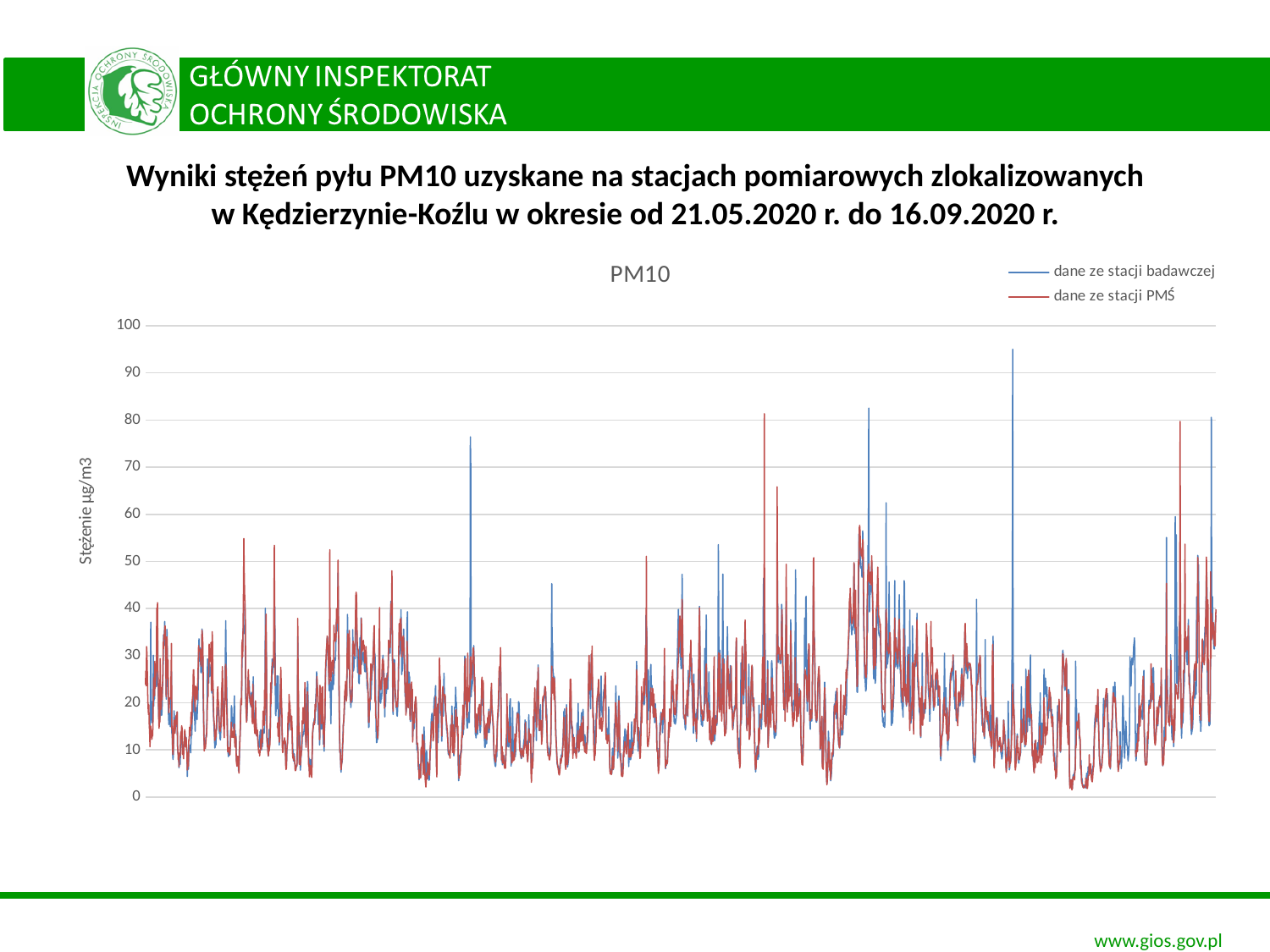
Is the highest peak of the 'dane ze stacji badawczej' series greater or less than 90? greater Which series reaches the higher maximum value in the chart, 'dane ze stacji badawczej' or 'dane ze stacji PMŚ'? dane ze stacji badawczej Which series is drawn in blue in the PM10 chart? dane ze stacji badawczej What kind of chart is shown on the slide? line chart Does any value in the chart exceed 100 on the vertical axis? No What is the label of the vertical axis of the chart? Stężenie µg/m3 Is the highest peak of the 'dane ze stacji PMŚ' series greater or less than 70? greater What is the title of the chart? PM10 How many series does the legend of the PM10 chart list? 2